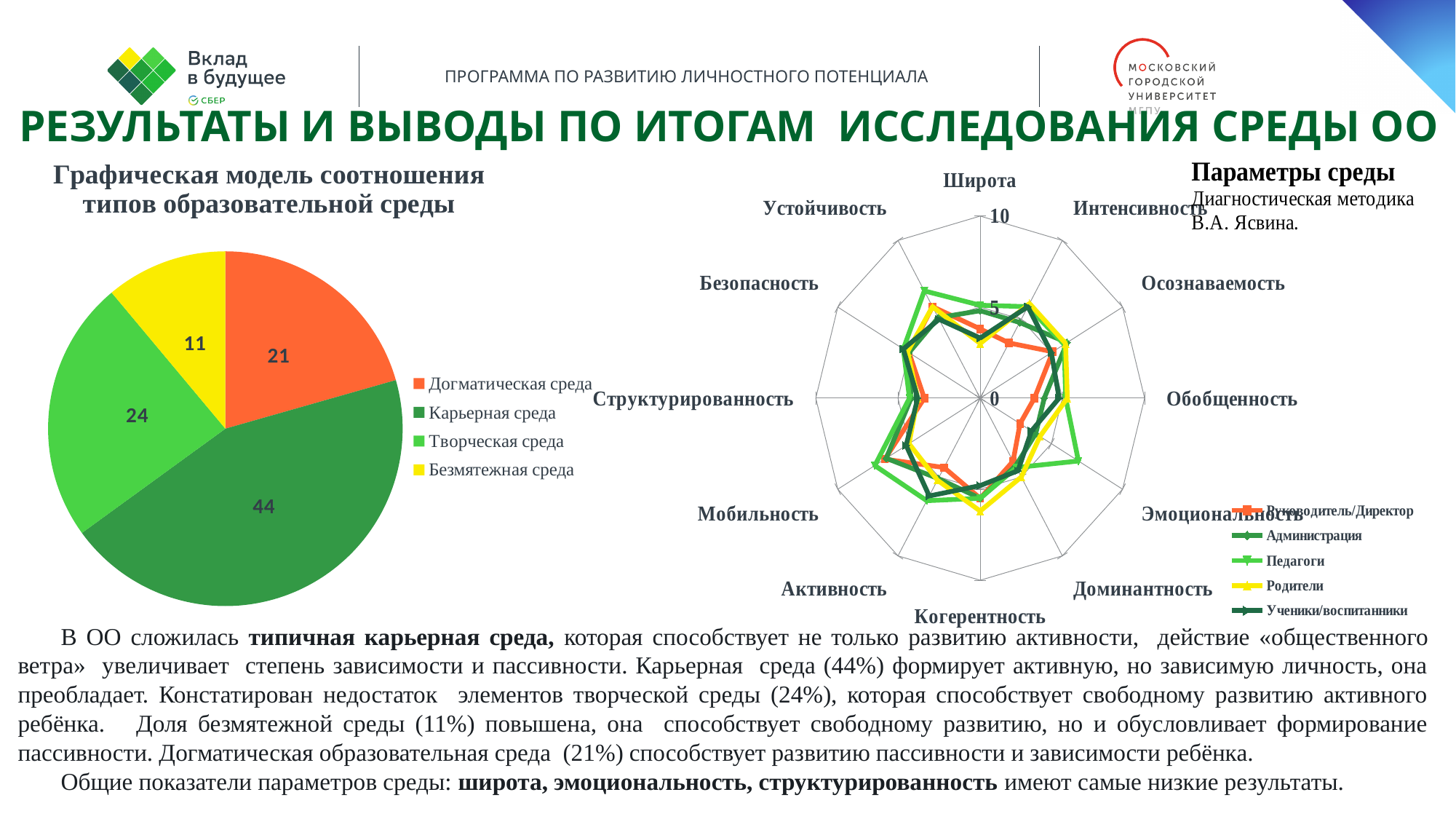
In the pie chart on the left, what is the difference between the values for Карьерная среда and Творческая среда? 20 In the pie chart on the left, which category has the smallest slice? Безмятежная среда What type of chart is the chart on the left of the slide? Pie chart In the pie chart on the left, which is larger: Догматическая среда or Творческая среда? Творческая среда In the pie chart on the left, what value is shown for Карьерная среда? 44 In the radar chart 'Параметры среды', how many parameters (axes) are plotted? 12 In the pie chart on the left, how many categories does the legend list? 4 In the pie chart on the left, what value is shown for Безмятежная среда? 11 In the pie chart on the left, which category has the largest slice? Карьерная среда In the radar chart 'Параметры среды', is the value for Руководитель/Директор on the Широта axis greater or less than 5? less In the radar chart 'Параметры среды', how many series does the legend list? 5 In the pie chart on the left, what value is shown for Догматическая среда? 21